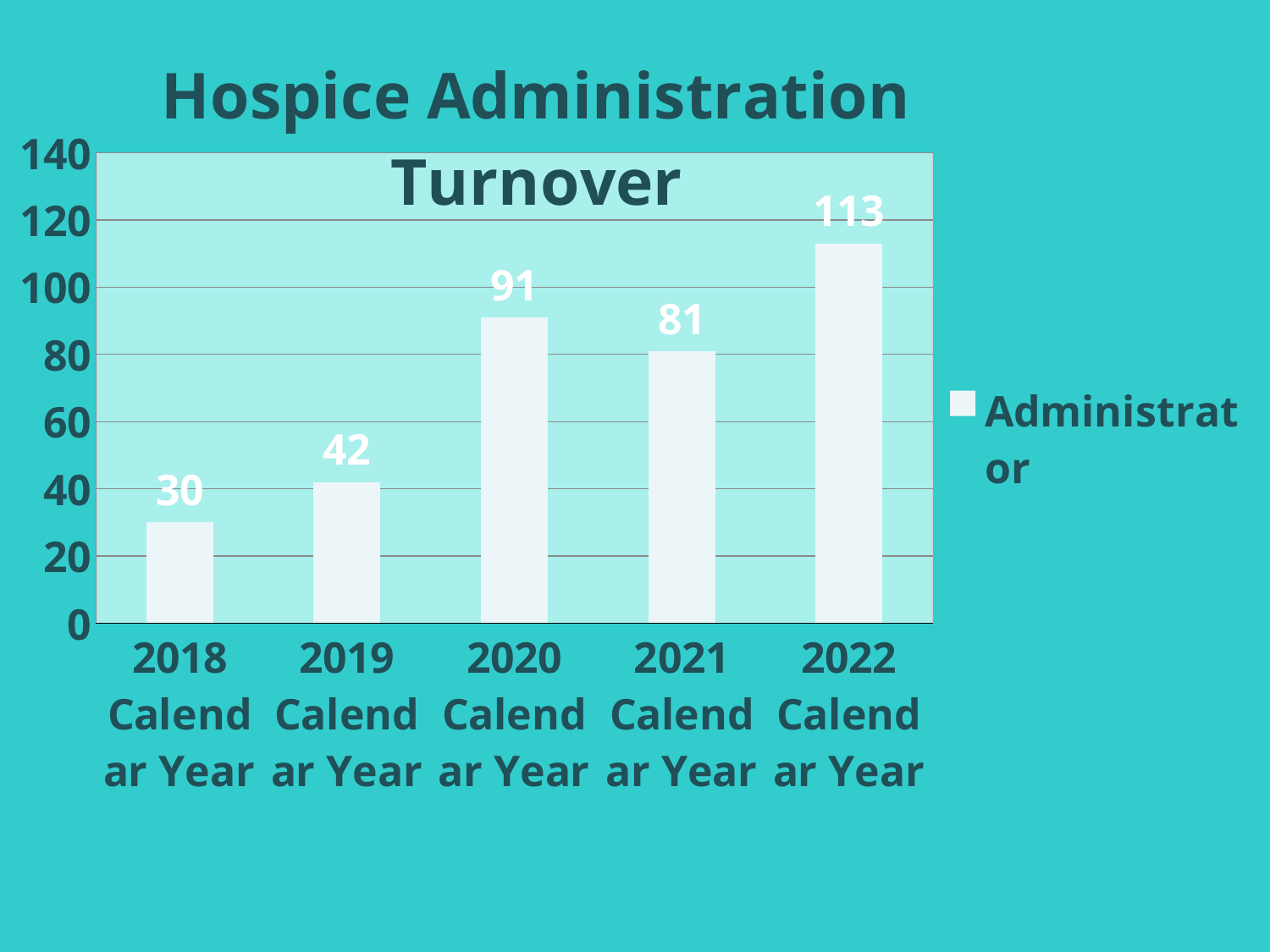
What is the difference between the Administrator turnover in 2020 and 2021? 10 What is the Administrator turnover value for 2018 Calendar Year? 30 What is the difference between the Administrator turnover in 2022 and 2018? 83 Which calendar year has the lowest Administrator turnover? 2018 Calendar Year How many calendar years are shown on the x axis? 5 What is the Administrator turnover value for 2021 Calendar Year? 81 Which is larger, the Administrator turnover in 2019 or in 2020? 2020 What kind of chart is shown on the slide? Bar chart Is the Administrator turnover for 2022 Calendar Year greater or less than 100? greater What is the Administrator turnover value for 2022 Calendar Year? 113 Which calendar year has the highest Administrator turnover? 2022 Calendar Year What is the title of the chart? Hospice Administration Turnover